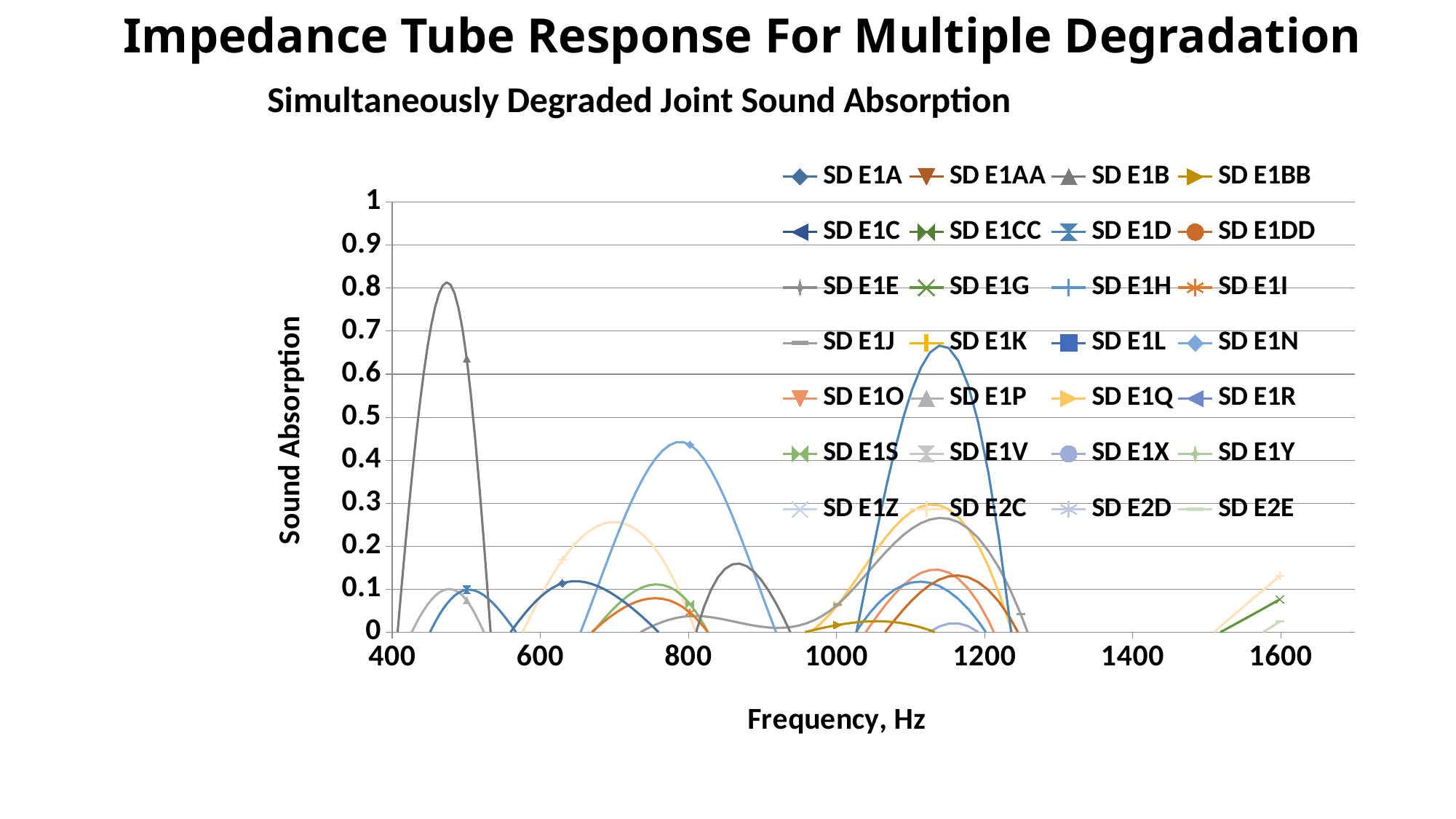
What is the label of the vertical axis? Sound Absorption Is the tallest peak located near 800 Hz greater or less than 0.6? less Is the highest value reached by any series near 1600 Hz greater or less than 0.3? less What kind of chart is shown on the slide? line chart What is the title of the chart? Simultaneously Degraded Joint Sound Absorption How many series does the legend list? 28 Is the tallest peak located between 1000 Hz and 1200 Hz greater or less than 0.5? greater